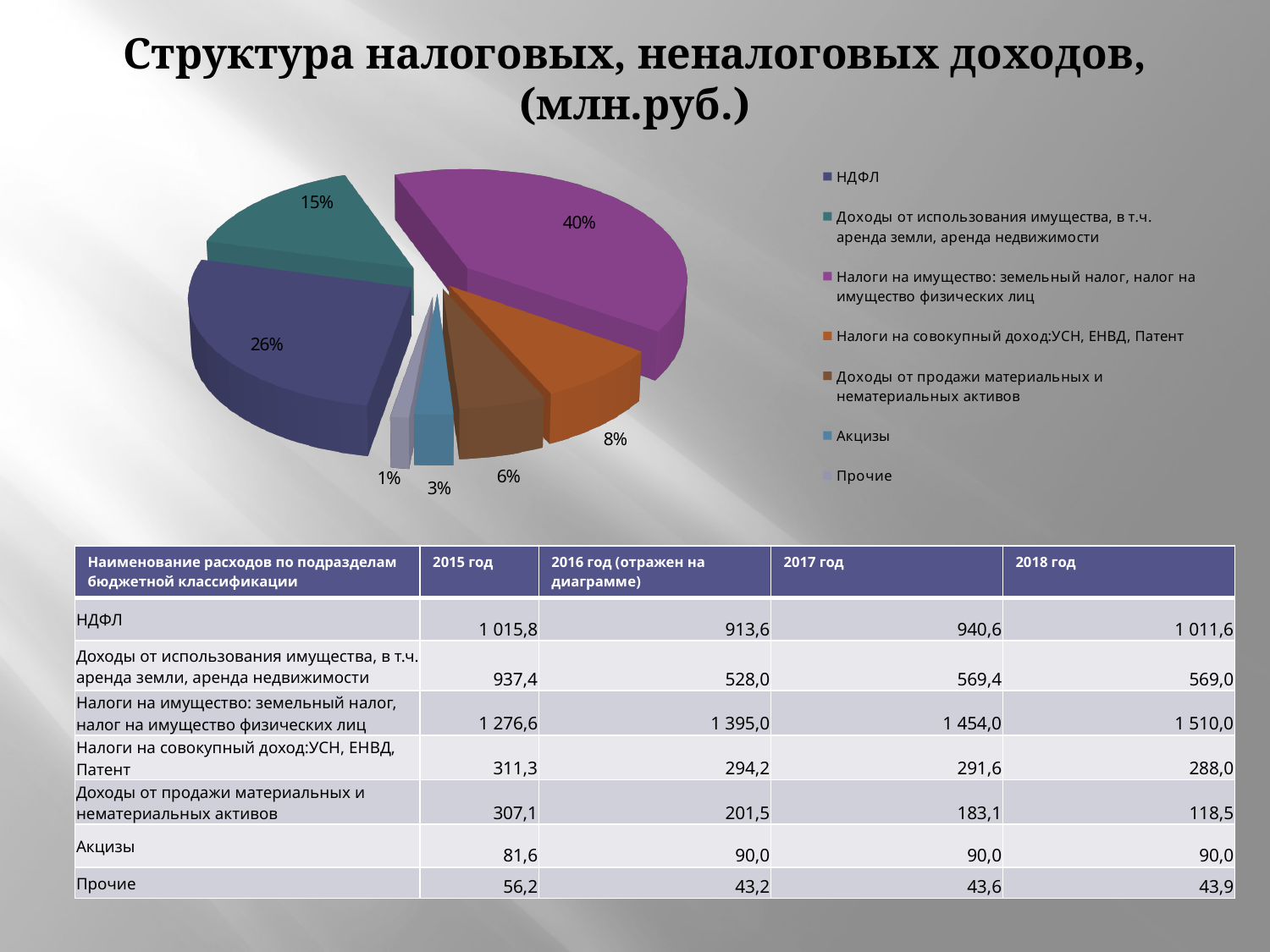
How many slices does the pie chart have? 7 What kind of chart is shown on the slide? pie chart What share of the pie does the slice for НДФЛ have? 26% What is the difference in percentage points between the slice for Налоги на имущество and the slice for НДФЛ? 14 Which category has the largest slice of the pie? Налоги на имущество: земельный налог, налог на имущество физических лиц What share of the pie does the slice for Налоги на имущество: земельный налог, налог на имущество физических лиц have? 40% Which category has the smallest slice of the pie? Прочие What share of the pie does the slice for Акцизы have? 3% How many entries does the chart legend list? 7 What is the title of the slide containing the pie chart? Структура налоговых, неналоговых доходов, (млн.руб.) Which slice is larger: Налоги на совокупный доход:УСН, ЕНВД, Патент or Доходы от продажи материальных и нематериальных активов? Налоги на совокупный доход:УСН, ЕНВД, Патент